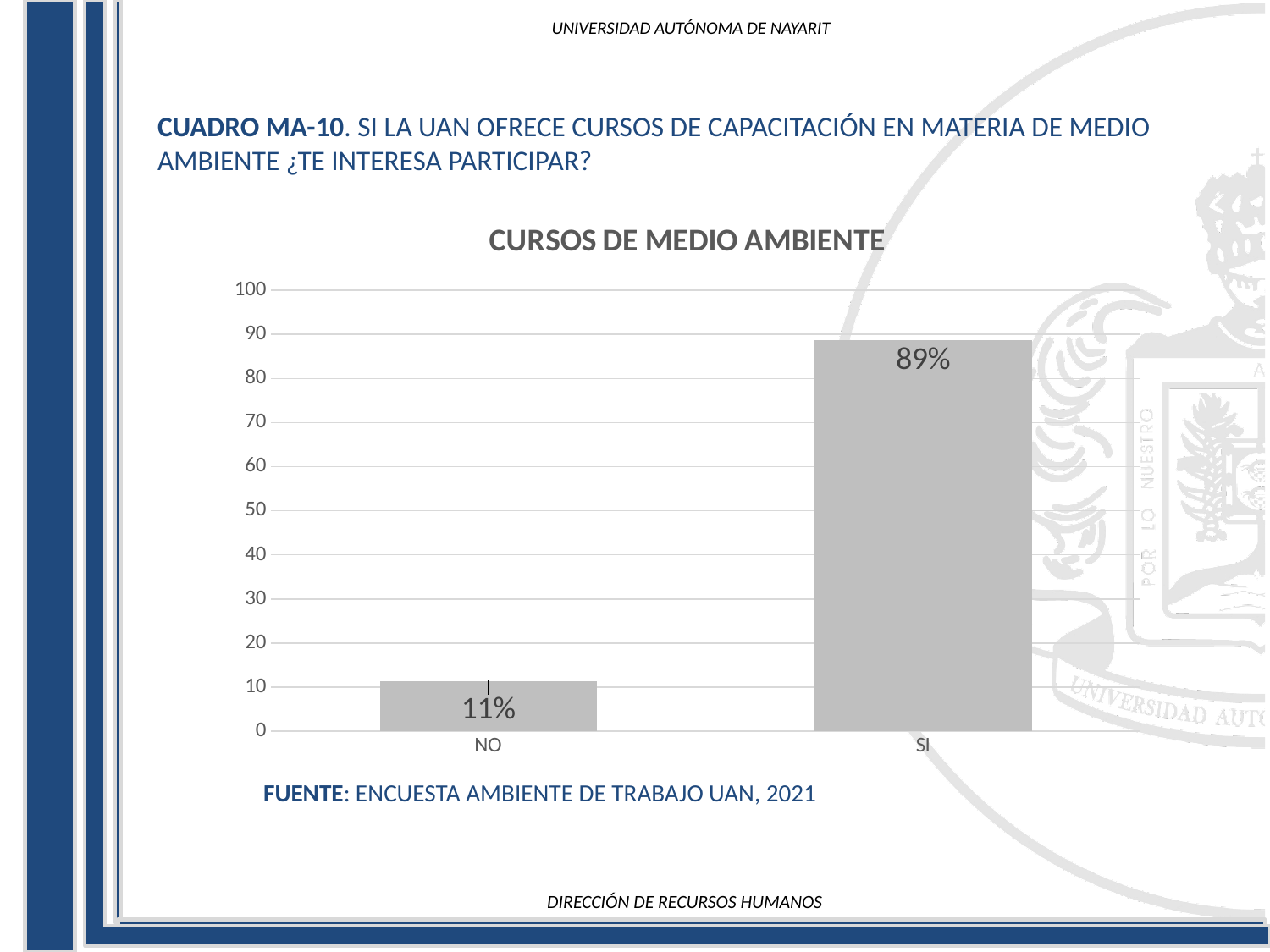
Which category has the lowest value? NO What is the value for NO? 11% Which category has the highest value? SI What kind of chart is shown on the slide? bar chart How many categories are shown on the x axis? 2 What is the maximum value shown on the y axis? 100 What is the title of the chart? CURSOS DE MEDIO AMBIENTE Is the value for NO greater or less than 20? less What is the value for SI? 89% Which is larger, the value for NO or the value for SI? SI What is the difference between the values for SI and NO? 78% Is the value for SI greater or less than 80? greater